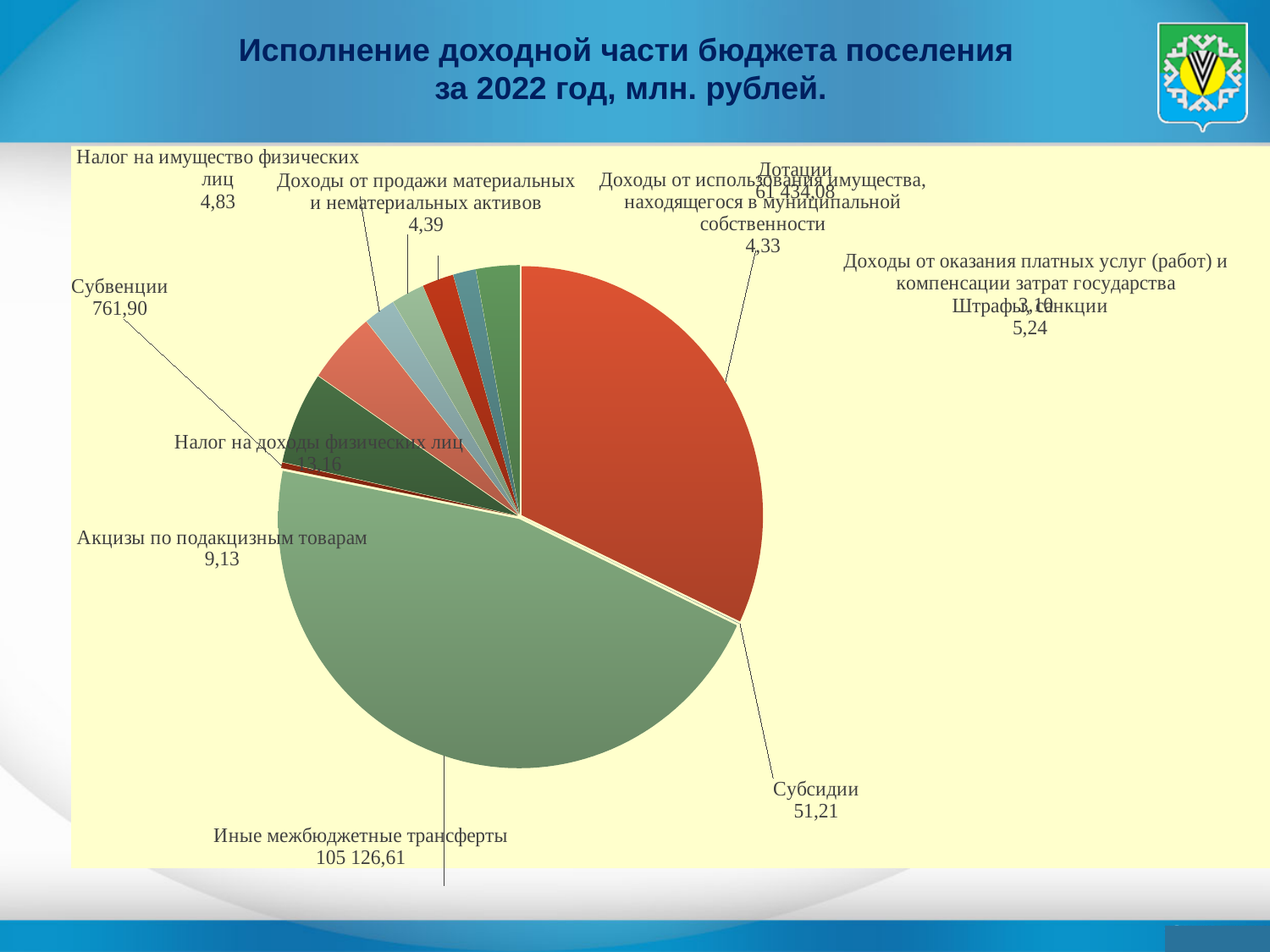
What is the title of the chart? Исполнение доходной части бюджета поселения за 2022 год, млн. рублей. Which category has the smallest labelled value? Доходы от оказания платных услуг (работ) и компенсации затрат государства What kind of chart is shown on the slide? pie chart What is the value for Иные межбюджетные трансферты? 105 126,61 What is the value for Субсидии? 51,21 What is the value for Акцизы по подакцизным товарам? 9,13 What is the difference between the values for Штрафы, санкции and Налог на имущество физических лиц? 0,41 What is the value for Штрафы, санкции? 5,24 What is the value for Налог на имущество физических лиц? 4,83 Which is larger, the value for Субсидии or the value for Акцизы по подакцизным товарам? Субсидии Which category has the largest slice of the pie? Иные межбюджетные трансферты What is the value for Субвенции? 761,90